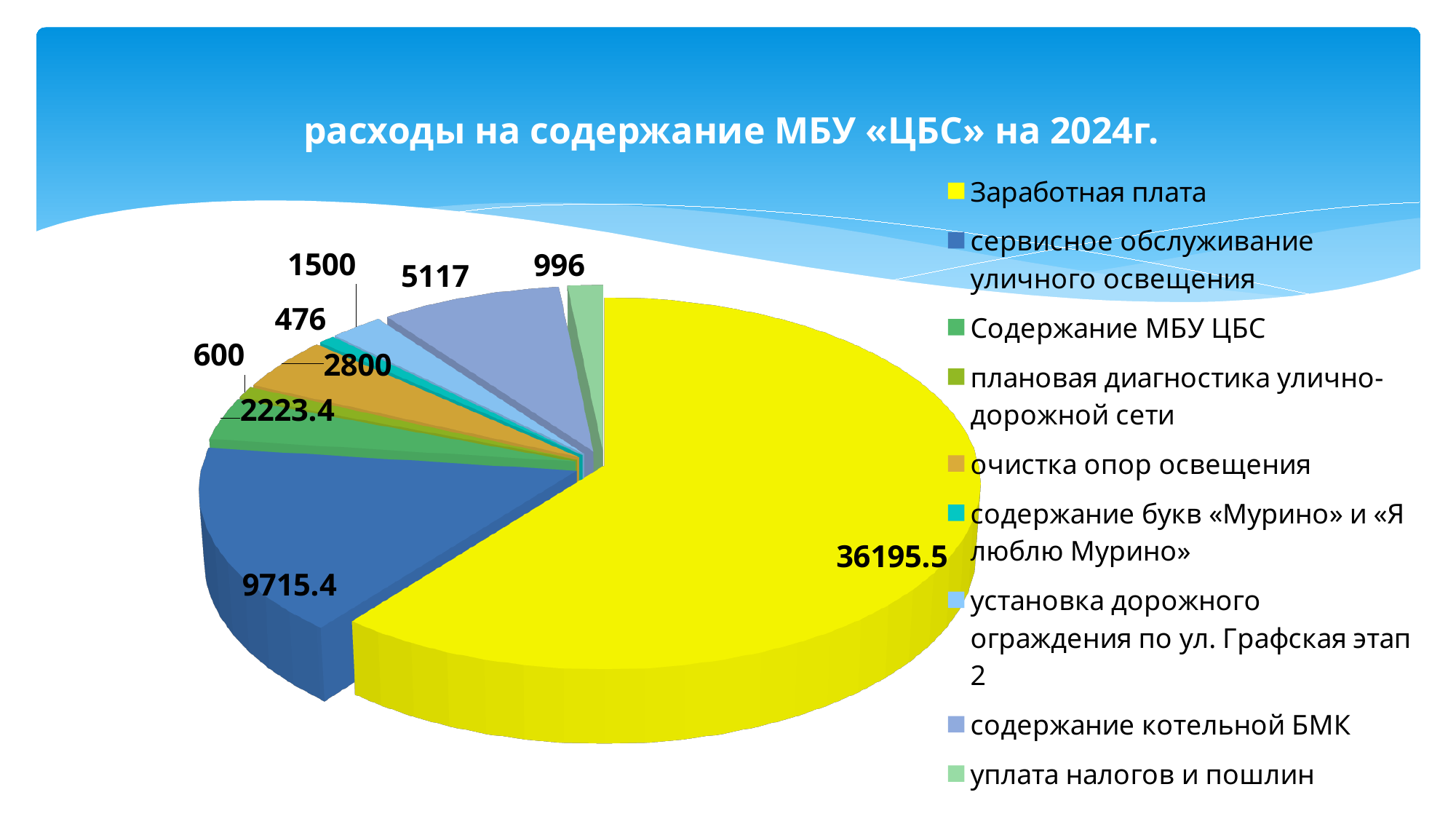
Which category has the smallest slice of the pie? содержание букв «Мурино» и «Я люблю Мурино» What is the difference between the values for сервисное обслуживание уличного освещения and содержание котельной БМК? 4598.4 What is the value for содержание букв «Мурино» и «Я люблю Мурино»? 476 Which is larger: очистка опор освещения or Содержание МБУ ЦБС? очистка опор освещения What is the value for очистка опор освещения? 2800 Which category has the largest slice of the pie? Заработная плата How many categories does the pie chart have? 9 What is the value for содержание котельной БМК? 5117 What is the value for сервисное обслуживание уличного освещения? 9715.4 What is the title of the chart? расходы на содержание МБУ «ЦБС» на 2024г. What kind of chart is shown on the slide? pie chart What is the value for Заработная плата? 36195.5